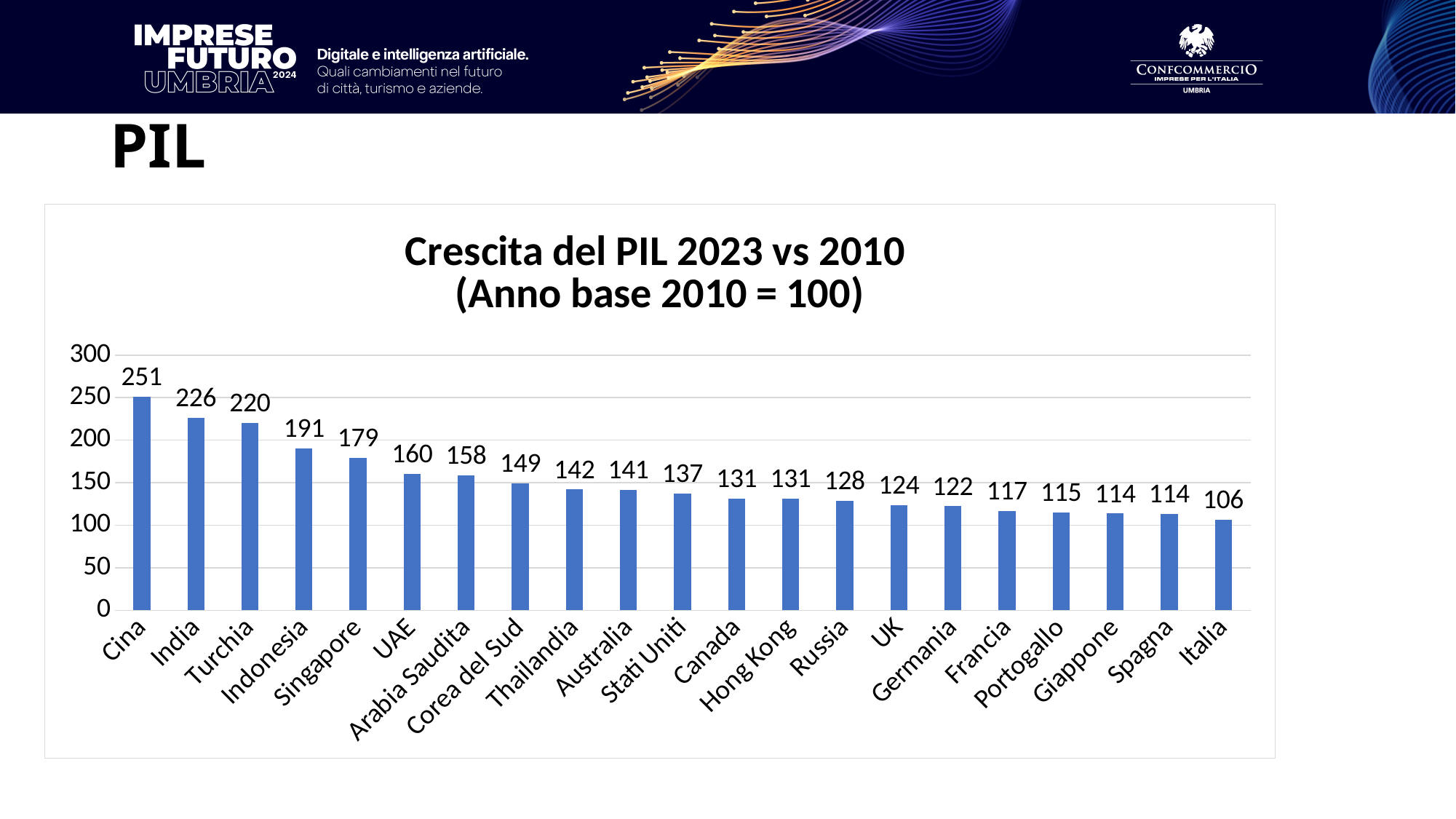
What is the value for Arabia Saudita? 158 What kind of chart is shown on the slide? Bar chart How many countries are shown in the chart? 21 Which country has the highest value? Cina What is the difference between the values for India and Turchia? 6 Which country has the lowest value? Italia What is the title of the chart? Crescita del PIL 2023 vs 2010 (Anno base 2010 = 100) What is the difference between the values for Cina and Italia? 145 What is the value for Cina? 251 What is the value for Germania? 122 Which is larger, the value for Indonesia or the value for Singapore? Indonesia Which is larger, the value for Francia or the value for UK? UK